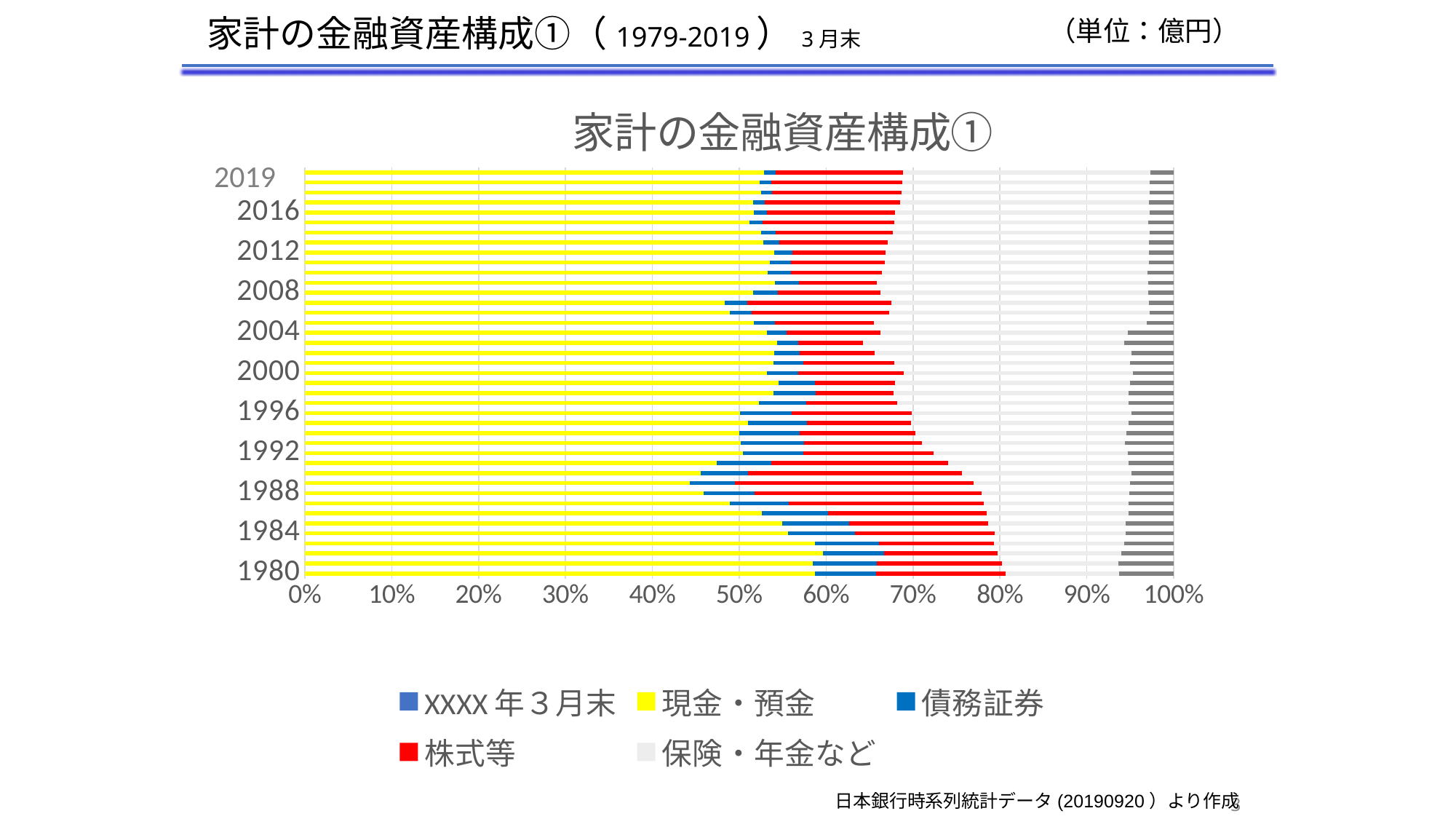
What is the title of the chart? 家計の金融資産構成① Which colour represents 株式等 in the chart? Red Is the 現金・預金 share for 2019 greater or less than 60%? less What kind of chart is shown on the slide? Stacked bar chart Does the 現金・預金 share rise or fall from 1988 to 2019? Rises How many series does the chart legend list? 5 Which year has the larger 保険・年金など share, 1980 or 2004? 2004 Is the 現金・預金 share for 1980 greater or less than 50%? greater Which year has the larger 現金・預金 share, 1980 or 1988? 1980 Is the 現金・預金 share for 1988 greater or less than 50%? less Which year has the larger 株式等 share, 1988 or 2019? 1988 Does the 株式等 share rise or fall from 1988 to 2019? Falls